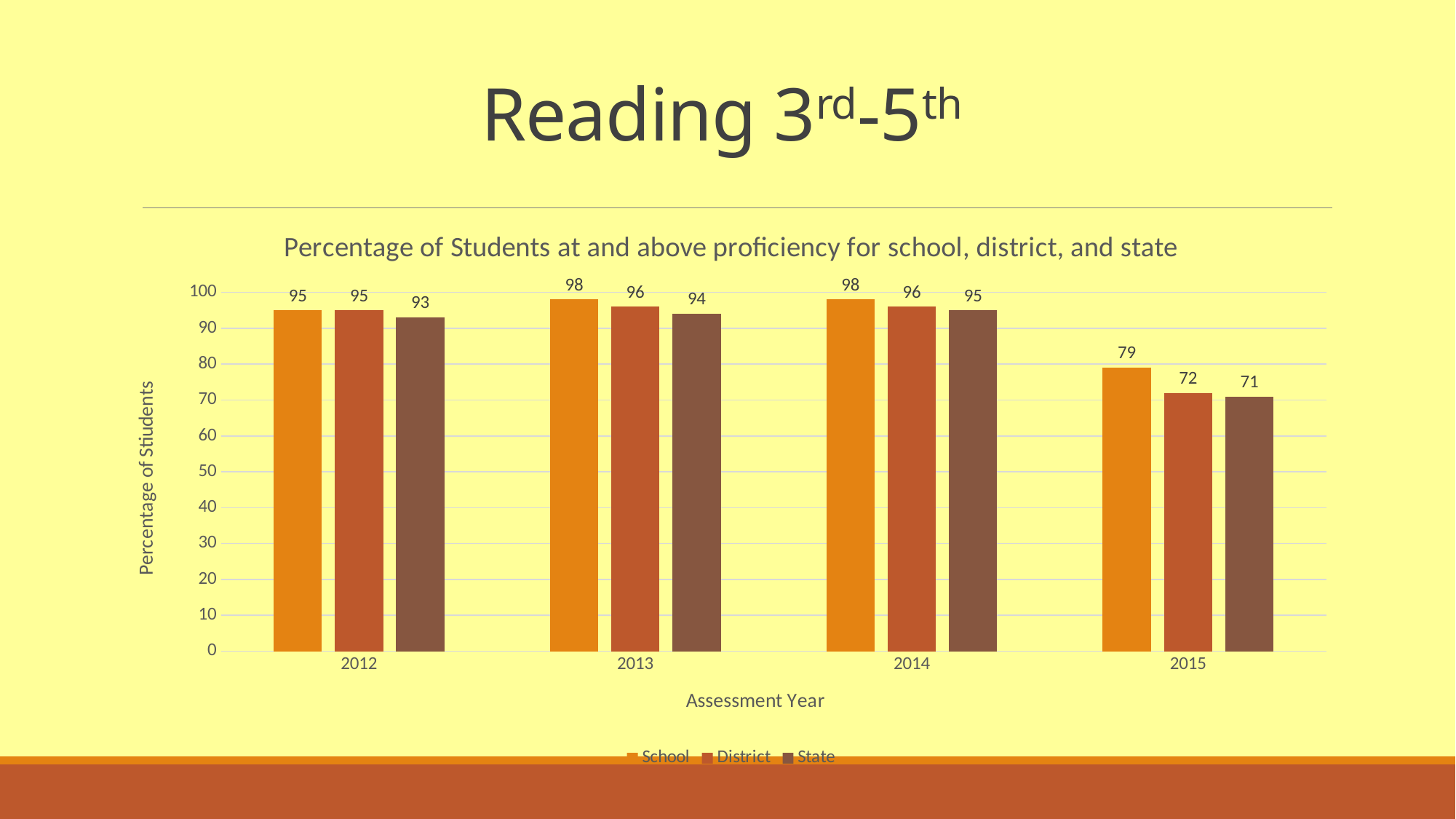
In which year is the School value lowest? 2015 How many series does the legend list? 3 Which is larger in 2014, the District value or the State value? District In which year is the State value highest? 2014 Is the District value for 2015 greater or less than 80? less What is the label of the y axis? Percentage of Stiudents How many assessment years are shown on the x axis? 4 What is the State value for 2015? 71 What kind of chart is shown on the slide? bar chart What is the District value for 2012? 95 What is the difference between the School and State values in 2015? 8 What is the School value for 2013? 98